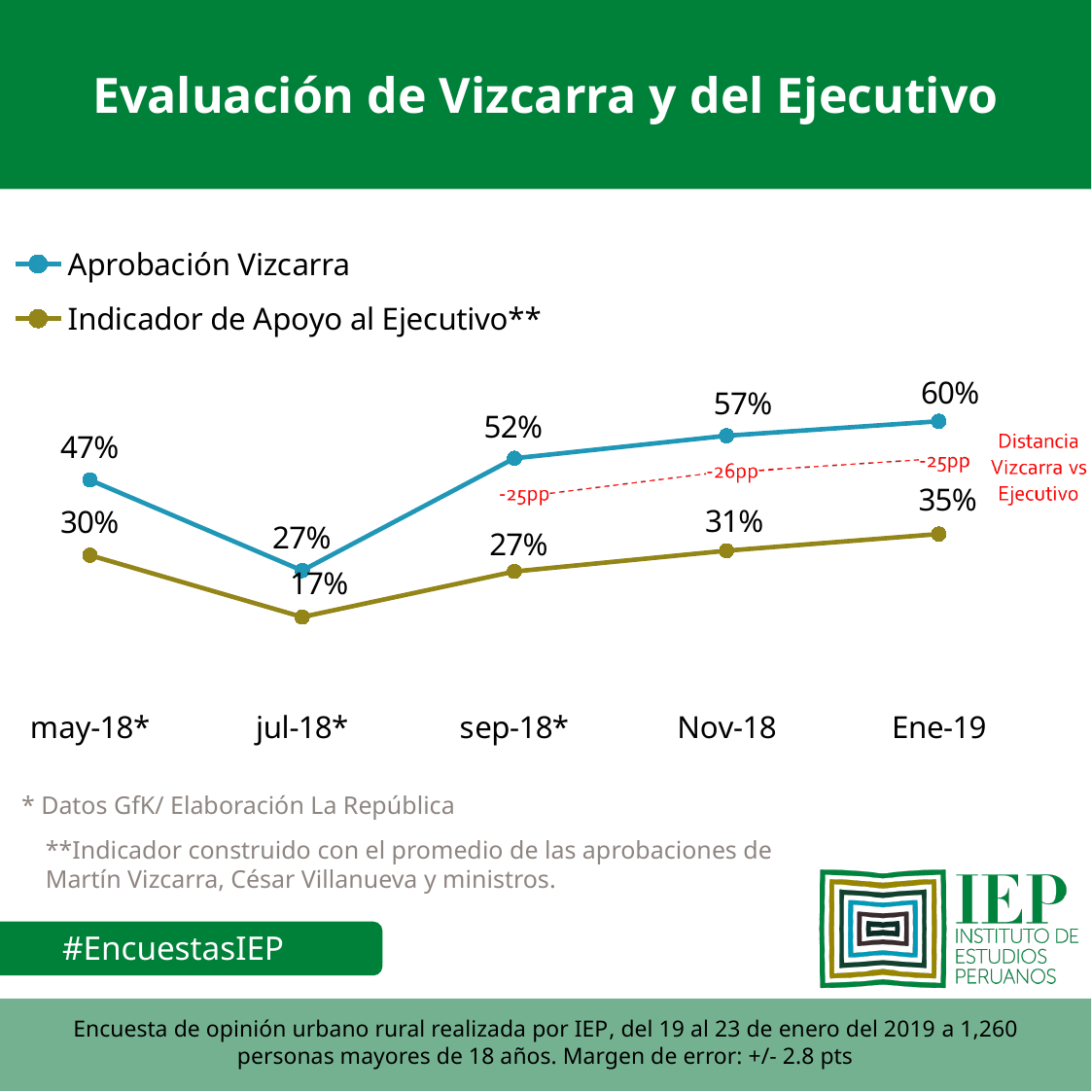
In which period is Aprobación Vizcarra lowest? jul-18* What is the Aprobación Vizcarra value for Ene-19? 60% What is the Indicador de Apoyo al Ejecutivo value for Nov-18? 31% What is the Aprobación Vizcarra value for sep-18*? 52% Which is larger in Nov-18: Aprobación Vizcarra or Indicador de Apoyo al Ejecutivo? Aprobación Vizcarra What kind of chart is shown on the slide? Line chart What is the Indicador de Apoyo al Ejecutivo value for jul-18*? 17% From sep-18* to Ene-19, does Aprobación Vizcarra rise or fall? Rise How many series does the legend list? 2 In which period is the Indicador de Apoyo al Ejecutivo highest? Ene-19 How many time periods are shown on the x axis? 5 What is the difference between Aprobación Vizcarra and Indicador de Apoyo al Ejecutivo in may-18*? 17 percentage points